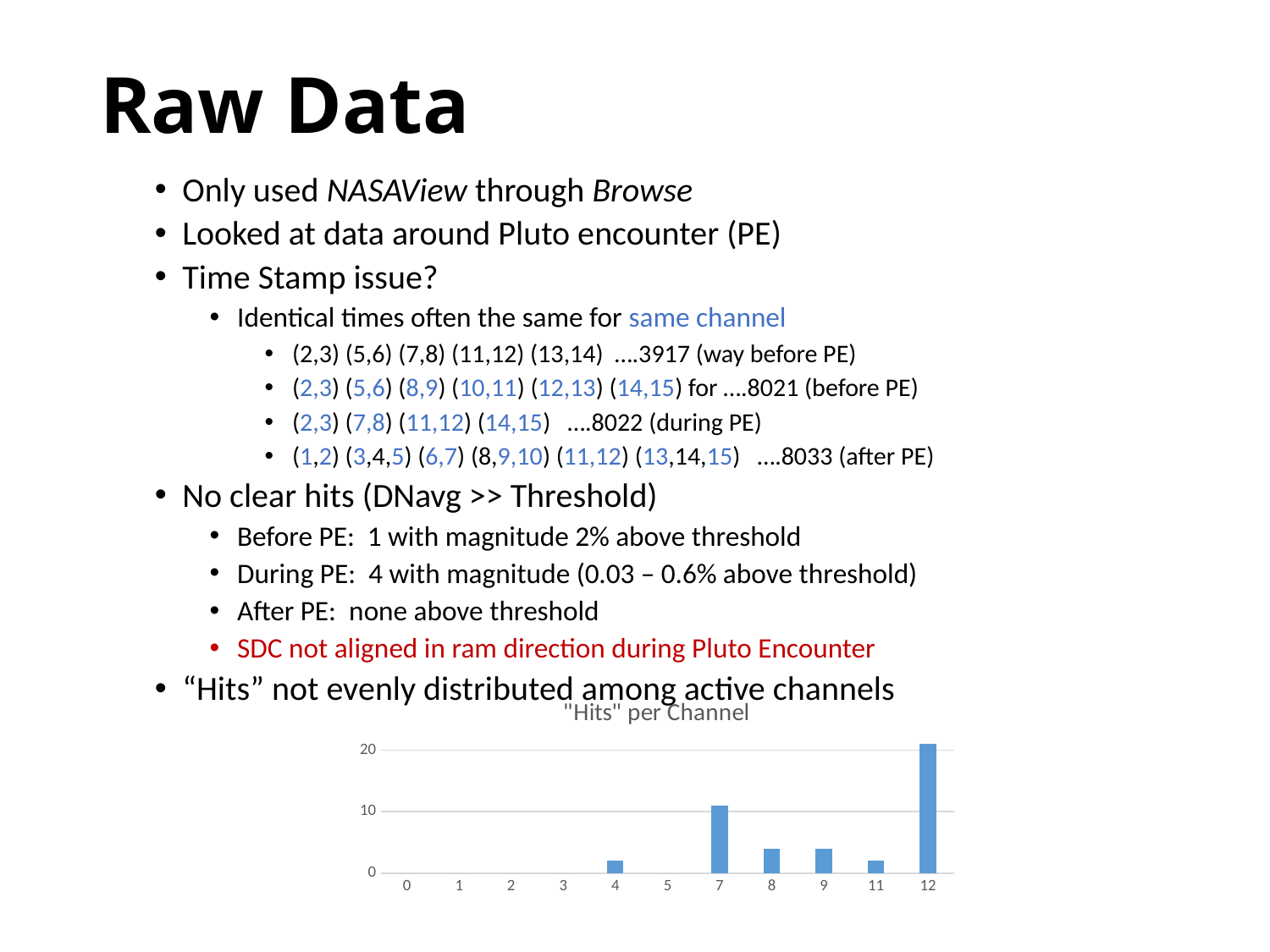
Is the value for channel 8 greater or less than 10? less What kind of chart is shown on the slide? bar chart Is the value for channel 12 greater or less than 10? greater Which channel has the highest number of hits in the chart? 12 Is the value for channel 4 greater or less than 10? less Which channel has the second-highest bar in the chart? 7 How many channel categories are shown on the x axis of the chart? 11 How many channels on the x axis show no visible bar (zero hits)? 5 Which channel has more hits, channel 7 or channel 8? 7 What is the highest tick value shown on the y axis of the chart? 20 Which channel has more hits, channel 12 or channel 7? 12 What is the title of the chart on the slide? "Hits" per Channel